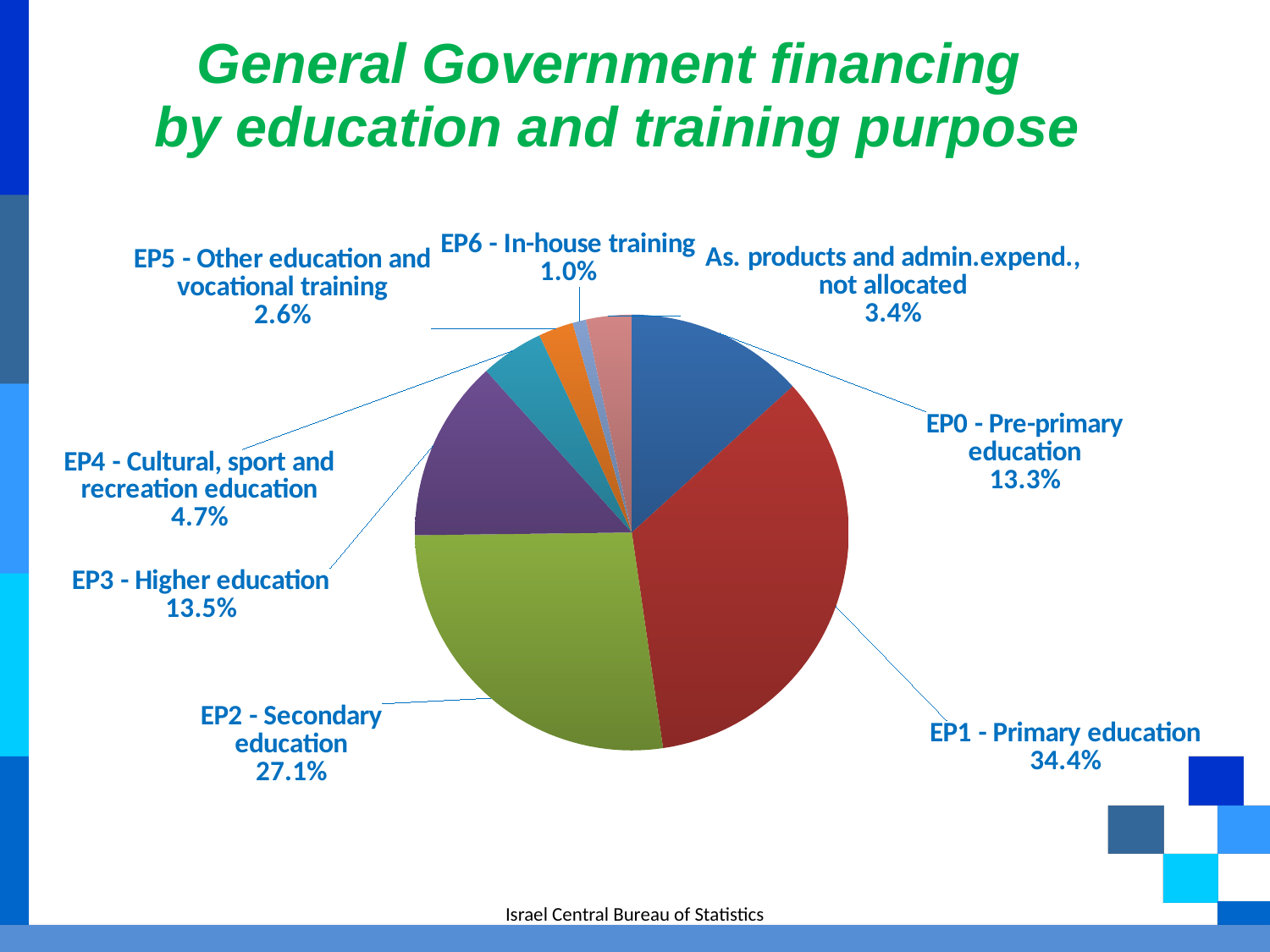
How many slices does the pie chart have? 8 Which education and training purpose has the largest share of financing? EP1 - Primary education What type of chart is shown on the slide? pie chart What percentage is shown for the 'As. products and admin.expend., not allocated' slice? 3.4% What percentage is shown for EP3 - Higher education? 13.5% What is the difference in percentage points between EP1 - Primary education and EP2 - Secondary education? 7.3 Which education and training purpose has the smallest share of financing? EP6 - In-house training What percentage is shown for EP2 - Secondary education? 27.1% Which has a larger share: EP4 - Cultural, sport and recreation education or EP5 - Other education and vocational training? EP4 - Cultural, sport and recreation education What share of General Government financing goes to EP1 - Primary education? 34.4% What percentage is shown for EP6 - In-house training? 1.0% What is the title of the slide? General Government financing by education and training purpose